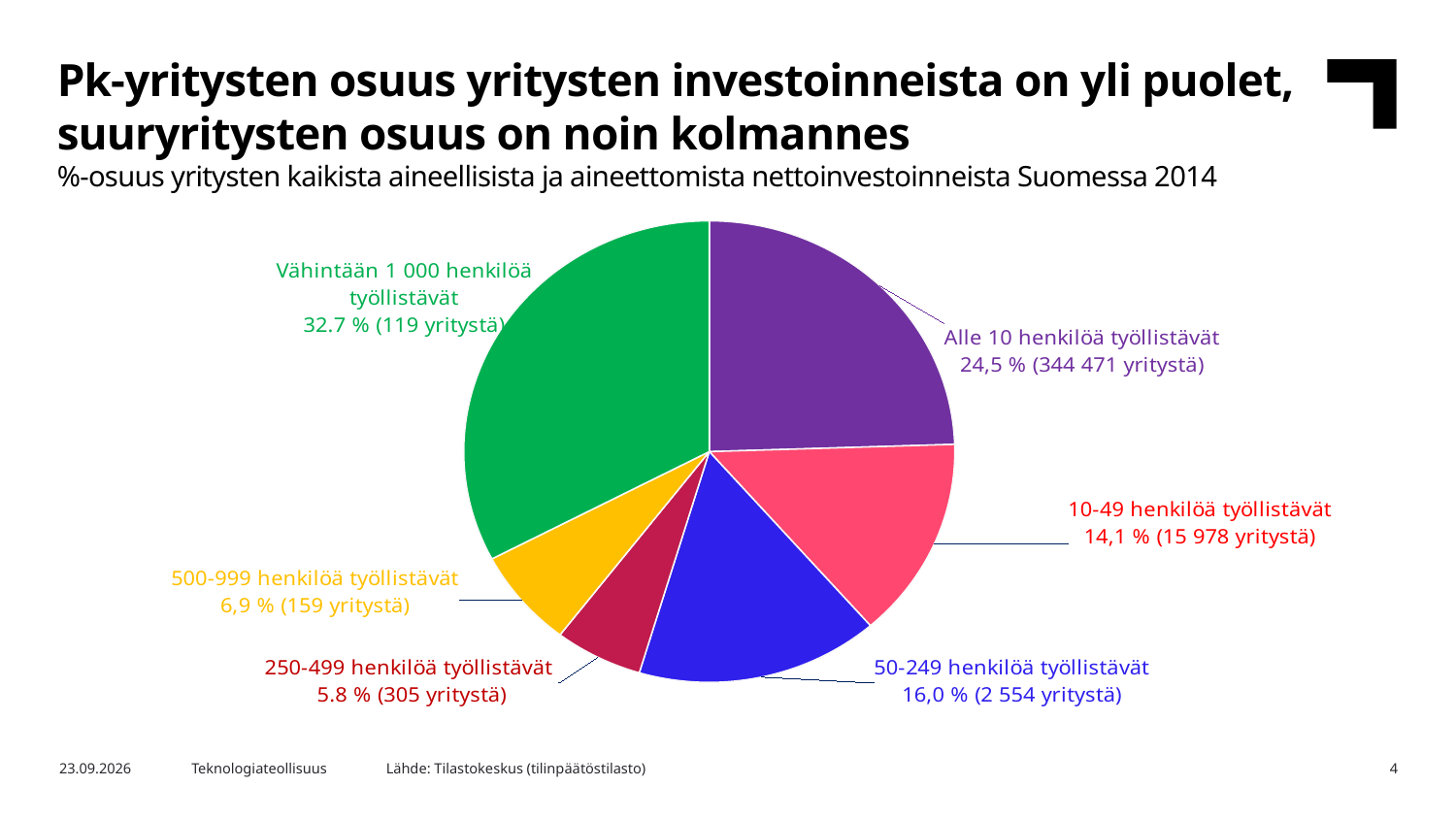
How many slices does the pie chart have? 6 Which has a larger share: 'Alle 10 henkilöä työllistävät' or '50-249 henkilöä työllistävät'? Alle 10 henkilöä työllistävät What share of the pie does '10-49 henkilöä työllistävät' represent? 14,1 % Which category has the smallest share of the pie? 250-499 henkilöä työllistävät How many companies are listed for '50-249 henkilöä työllistävät'? 2 554 yritystä What percentage share is shown for '500-999 henkilöä työllistävät'? 6,9 % What is the difference in percentage share between 'Vähintään 1 000 henkilöä työllistävät' and '250-499 henkilöä työllistävät'? 26.9 % What type of chart is shown on the slide? Pie chart What colour is the slice for 'Vähintään 1 000 henkilöä työllistävät'? Green What percentage share is shown for 'Alle 10 henkilöä työllistävät'? 24,5 % Which category has the largest share of the pie? Vähintään 1 000 henkilöä työllistävät What is the difference in percentage share between '50-249 henkilöä työllistävät' and '10-49 henkilöä työllistävät'? 1,9 %